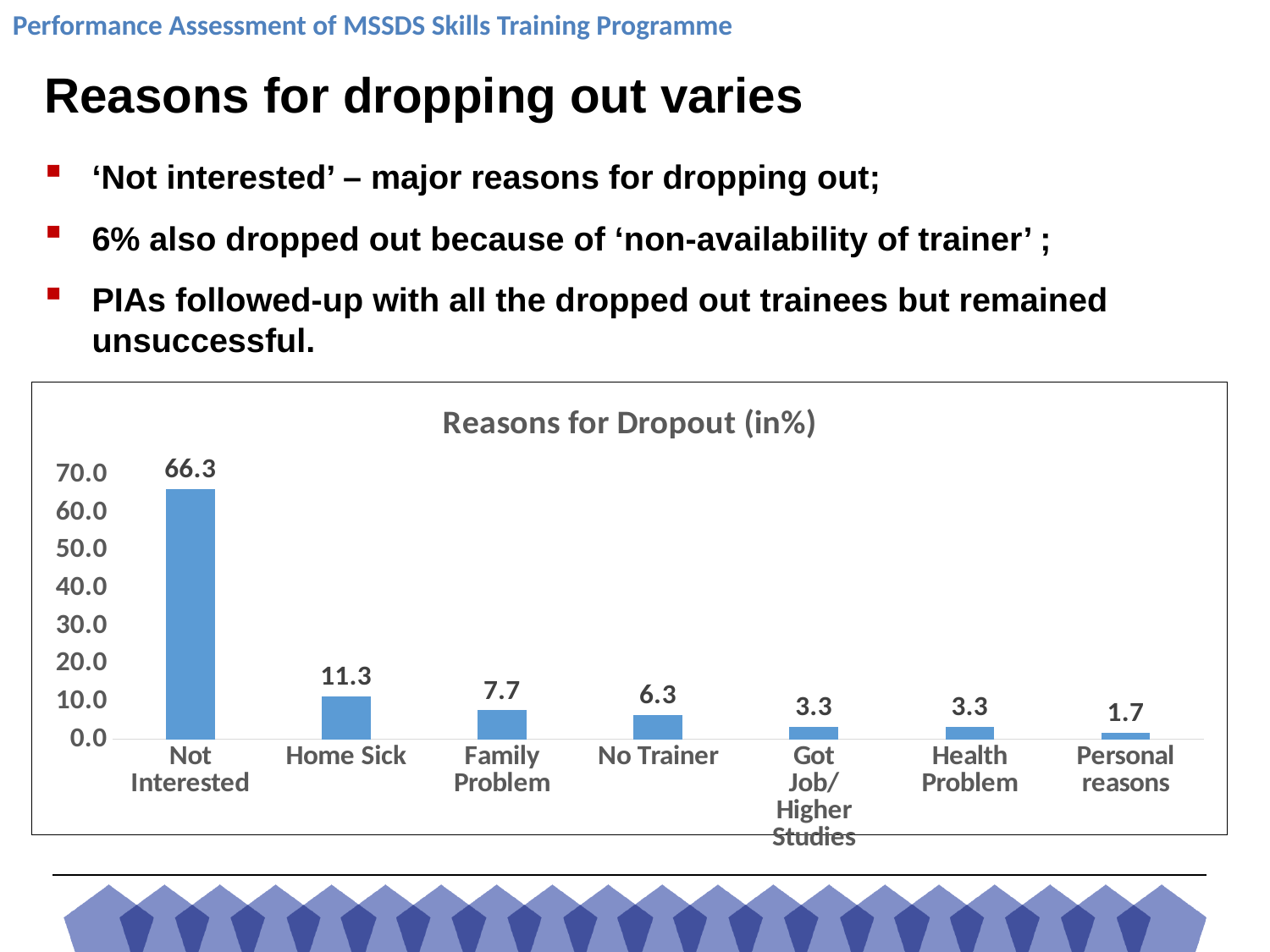
What kind of chart is shown on the slide? Bar chart What is the value for Home Sick? 11.3 What is the value for Not Interested in the Reasons for Dropout chart? 66.3 Which reason has the lowest dropout percentage? Personal reasons What is the value for Personal reasons? 1.7 What is the difference between the values for Not Interested and Home Sick? 55.0 What is the difference between the values for Family Problem and No Trainer? 1.4 What is the value for No Trainer? 6.3 Which reason has the highest dropout percentage? Not Interested What is the title of the chart? Reasons for Dropout (in%) Which is larger, the value for Home Sick or the value for Family Problem? Home Sick How many reasons (categories) are shown in the chart? 7